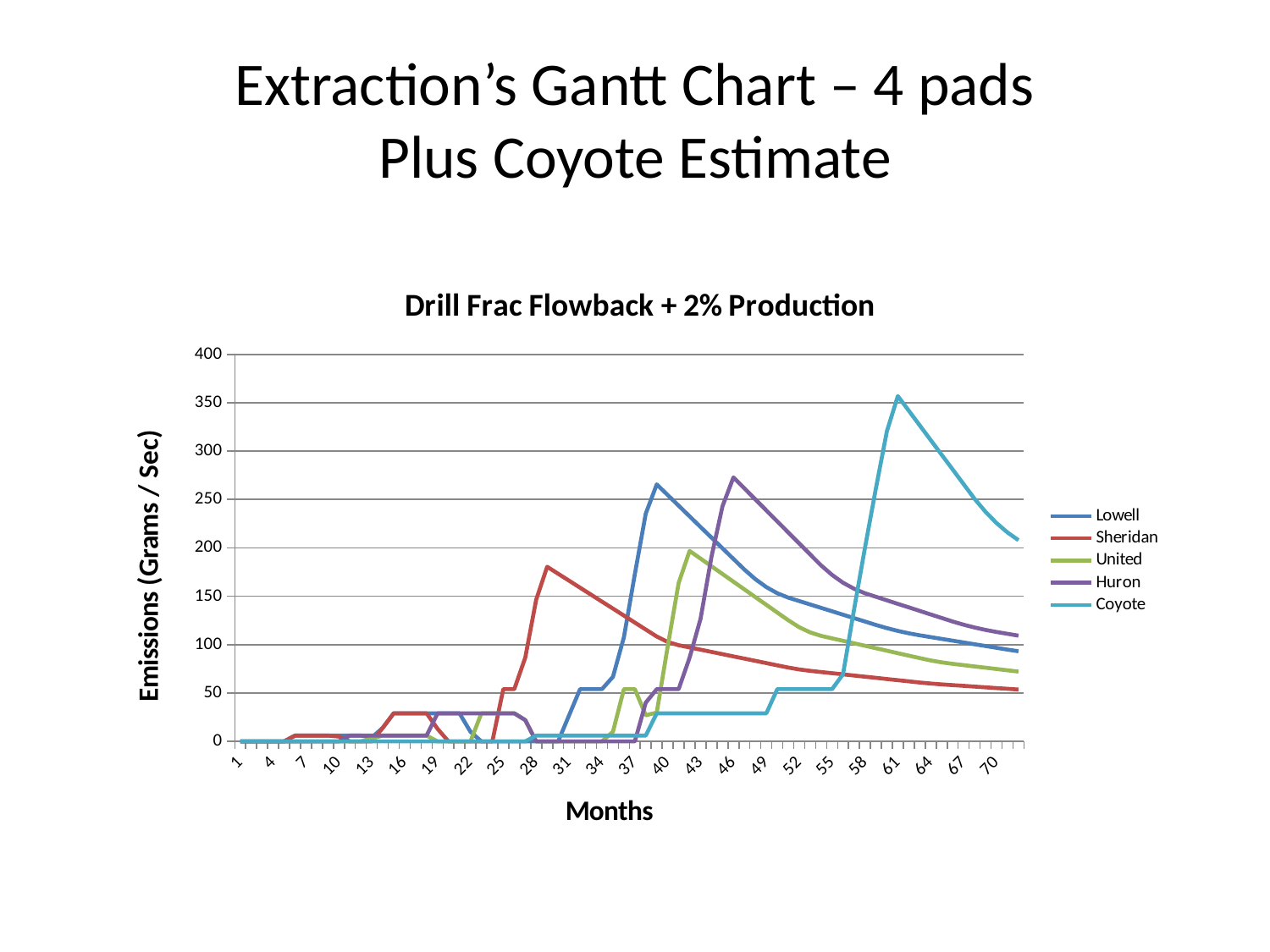
What is the label on the vertical axis of the chart? Emissions (Grams / Sec) After reaching its peak, do the values for Coyote rise or fall toward month 70? fall What kind of chart is shown on the slide? line chart Is the peak value for Coyote greater or less than 300? greater Which series reaches the highest peak value on the chart? Coyote How many series does the legend list? 5 Is the peak value for Huron greater or less than 250? greater Which is larger, the peak value for Coyote or the peak value for Huron? Coyote Is the peak value for Sheridan greater or less than 200? less What is the title of the chart? Drill Frac Flowback + 2% Production Which series reaches its peak earliest along the Months axis? Sheridan What is the value for Lowell at month 1? 0